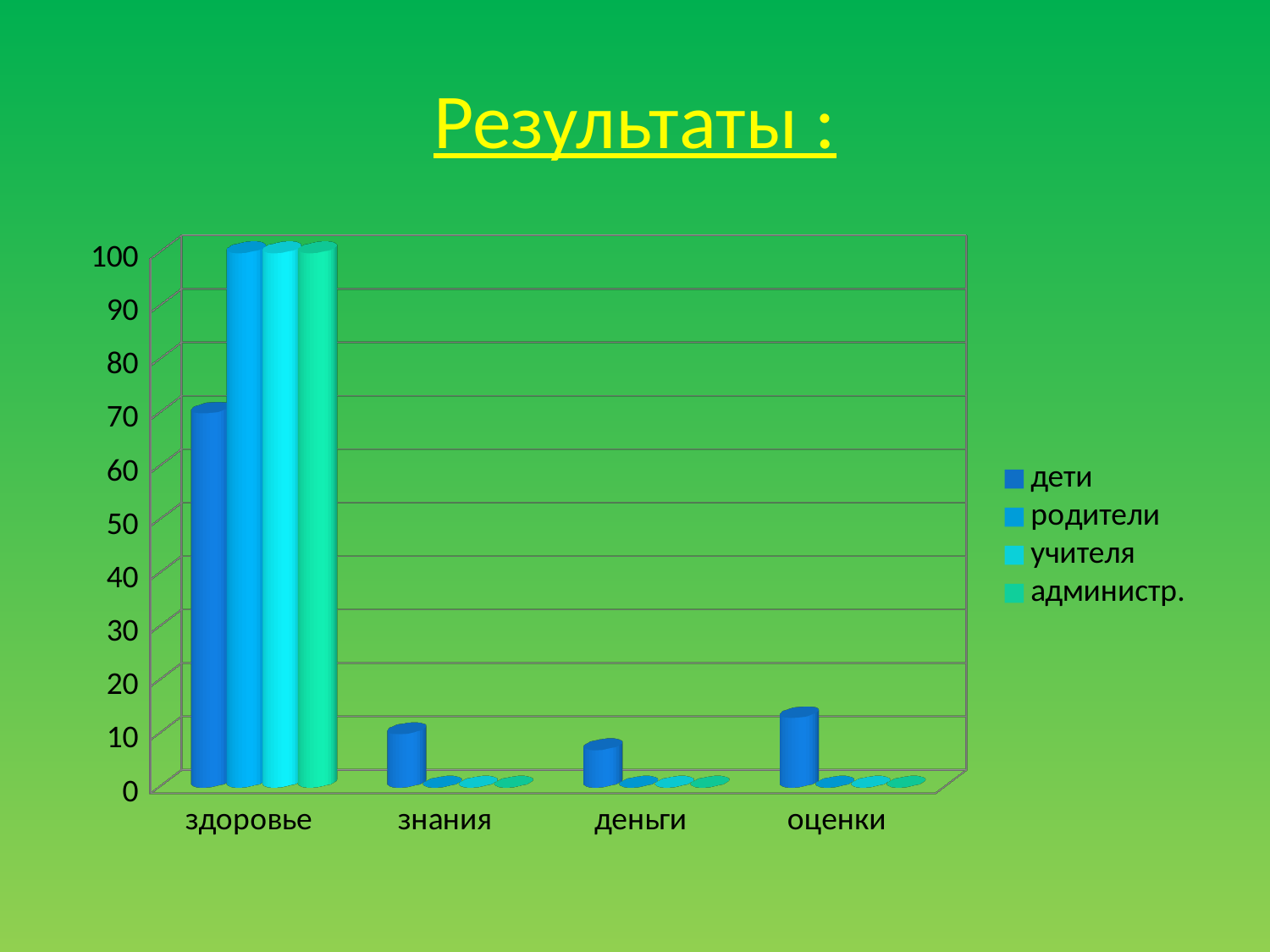
Which series is listed last in the legend? администр. How many series does the legend list? 4 Is the value for дети in the здоровье category greater or less than 80? less Which category has the highest value for the дети series? здоровье What is the value for учителя in the здоровье category? 100 What kind of chart is shown on the slide? bar chart Is the value for дети in the здоровье category greater or less than 60? greater For the дети series, which is larger: the value for знания or the value for оценки? оценки Which category has the lowest value for the дети series? деньги How many categories are shown on the x axis? 4 What is the title of the slide above the chart? Результаты : What is the value for родители in the здоровье category? 100